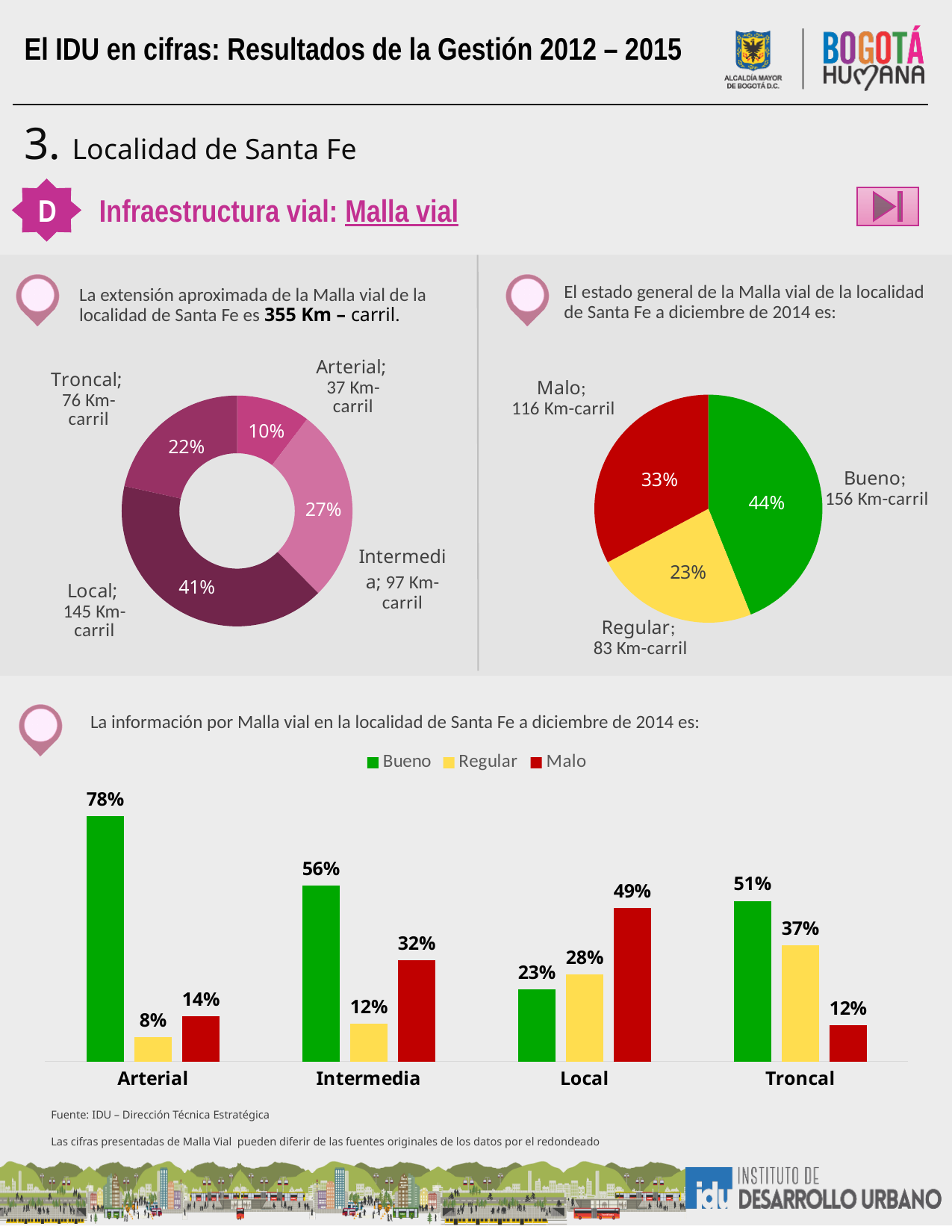
In the top-left donut chart, how many categories are shown? 4 In the bottom bar chart, what is the Malo value for Local? 49% In the bottom bar chart, which is larger for Intermedia: Regular or Malo? Malo What type of chart is shown at the bottom of the slide? Bar chart In the top-left donut chart, what share of the road network is Local? 41% In the top-right pie chart, how many Km-carril are in Bueno condition? 156 Km-carril In the bottom bar chart, how many series does the legend list? 3 In the top-left donut chart, which category has the smallest share? Arterial In the bottom bar chart, what is the difference between the Bueno values for Arterial and Troncal? 27% In the top-left donut chart, how many Km-carril does Troncal account for? 76 Km-carril In the top-right pie chart, which condition has the largest share? Bueno In the top-right pie chart, what share of the road network is in Malo condition? 33%